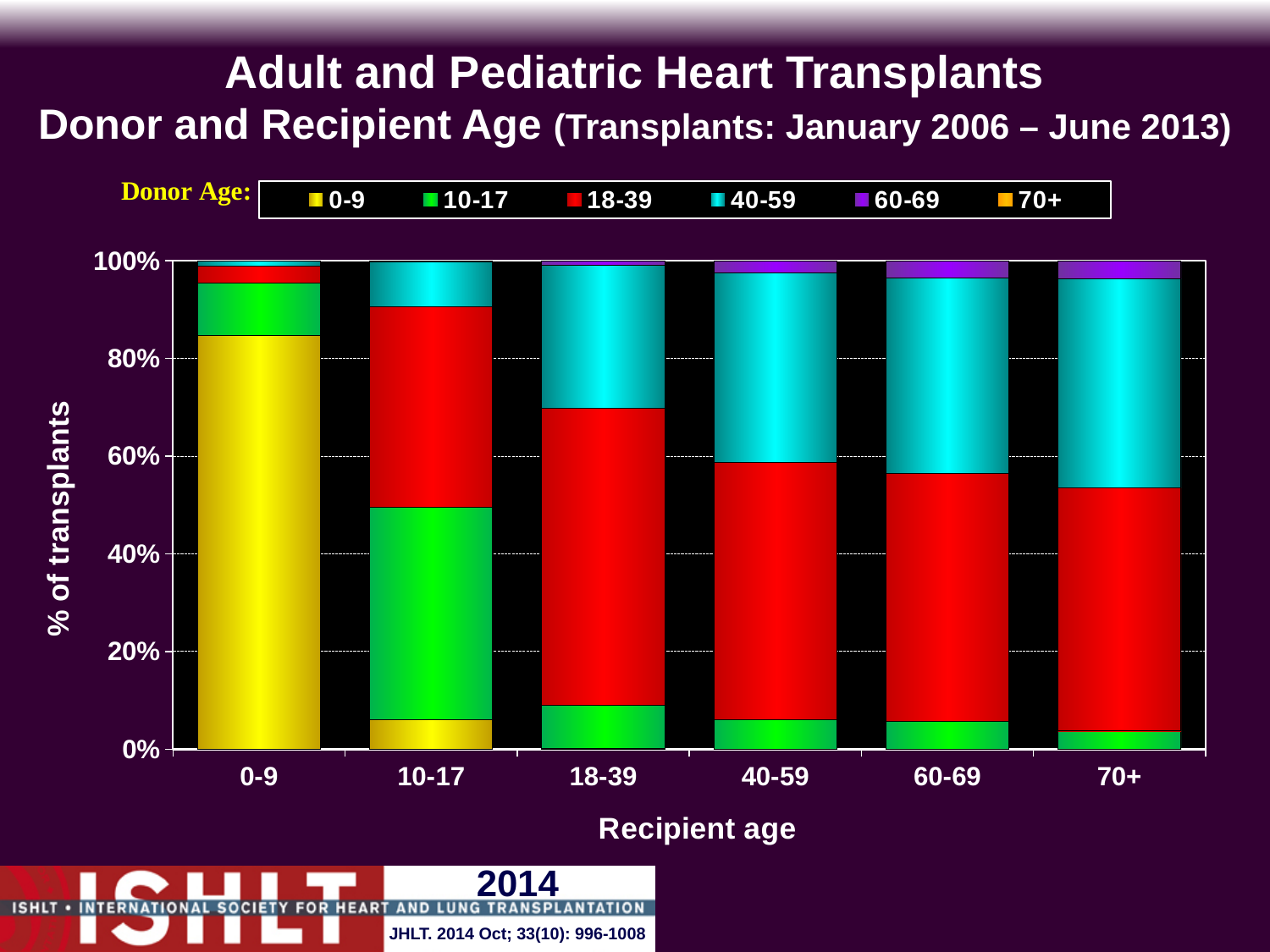
Which colour represents donors aged 40-59 in the legend? cyan Across the recipient age groups 18-39, 40-59, 60-69 and 70+, does the share of transplants from donors aged 18-39 rise or fall? fall How many donor age series does the legend list? 6 Which recipient age group has the largest share of transplants from donors aged 0-9? 0-9 What is the label of the y axis? % of transplants Which recipient age group has a larger share of transplants from donors aged 40-59: 18-39 or 70+? 70+ Across the recipient age groups 18-39, 40-59, 60-69 and 70+, does the share of transplants from donors aged 40-59 rise or fall? rise Is the share of transplants from donors aged 10-17 in the 10-17 recipient age group greater or less than 40%? greater Is the share of transplants from donors aged 0-9 in the 0-9 recipient age group greater or less than 80%? greater Which recipient age group has a larger share of transplants from donors aged 18-39: 10-17 or 70+? 70+ What kind of chart is shown on the slide? stacked bar chart How many recipient age categories are shown on the x axis? 6